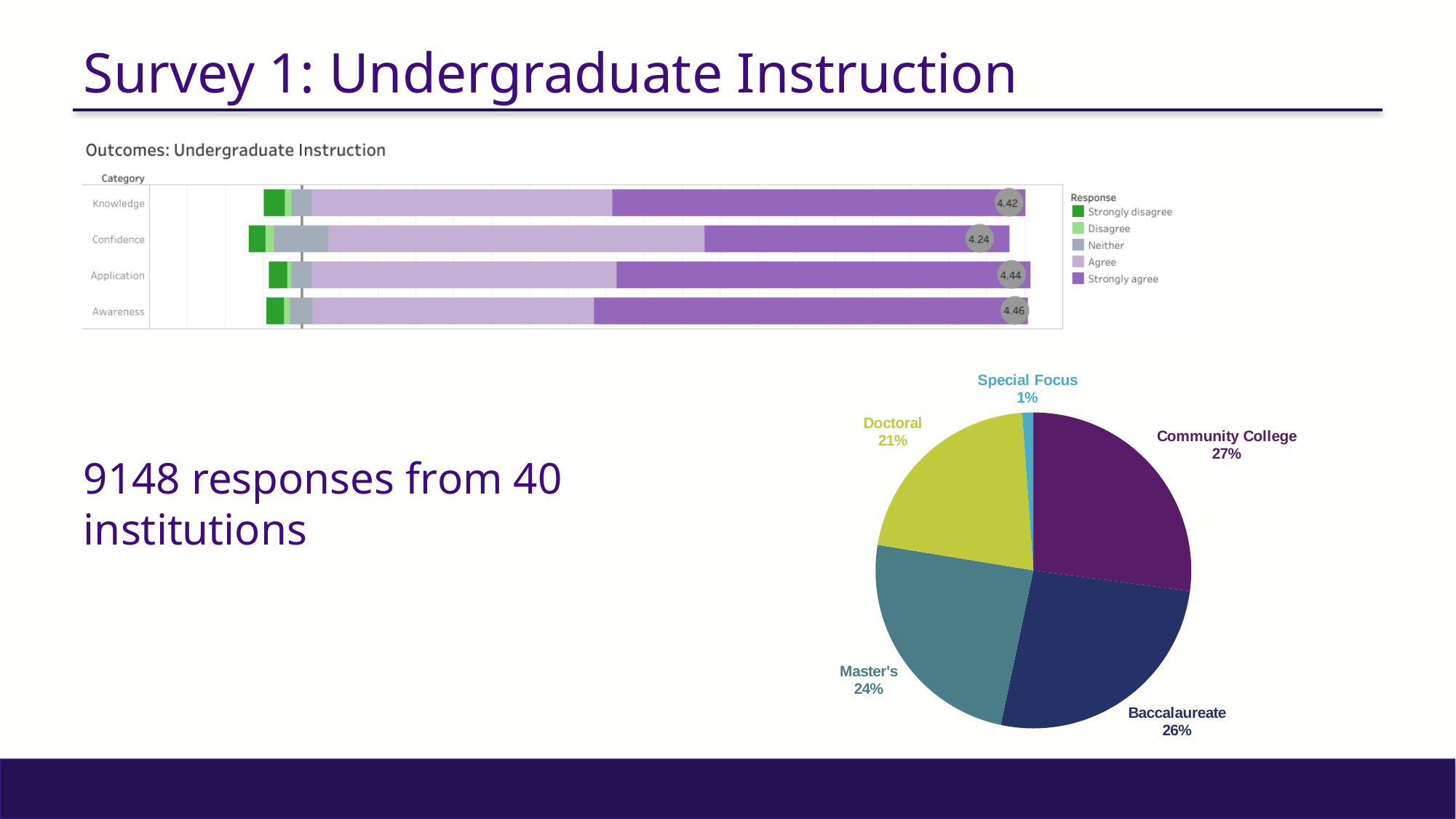
In the pie chart on the lower right, which institution type has the smallest share? Special Focus In the pie chart on the lower right, what share is Community College? 27% In the 'Outcomes: Undergraduate Instruction' chart, which category has the highest mean score? Awareness In the pie chart on the lower right, which is larger: Master's or Doctoral? Master's In the 'Outcomes: Undergraduate Instruction' chart, what is the mean score shown for Knowledge? 4.42 In the 'Outcomes: Undergraduate Instruction' chart, what is the mean score shown for Confidence? 4.24 In the 'Outcomes: Undergraduate Instruction' chart, what is the difference between the mean scores for Awareness and Confidence? 0.22 In the pie chart on the lower right, how many slices are there? 5 What kind of chart is the 'Outcomes: Undergraduate Instruction' chart? Stacked bar chart In the 'Outcomes: Undergraduate Instruction' chart, how many response options does the legend list? 5 In the 'Outcomes: Undergraduate Instruction' chart, which category has the lowest mean score? Confidence In the 'Outcomes: Undergraduate Instruction' chart, how many categories are shown? 4